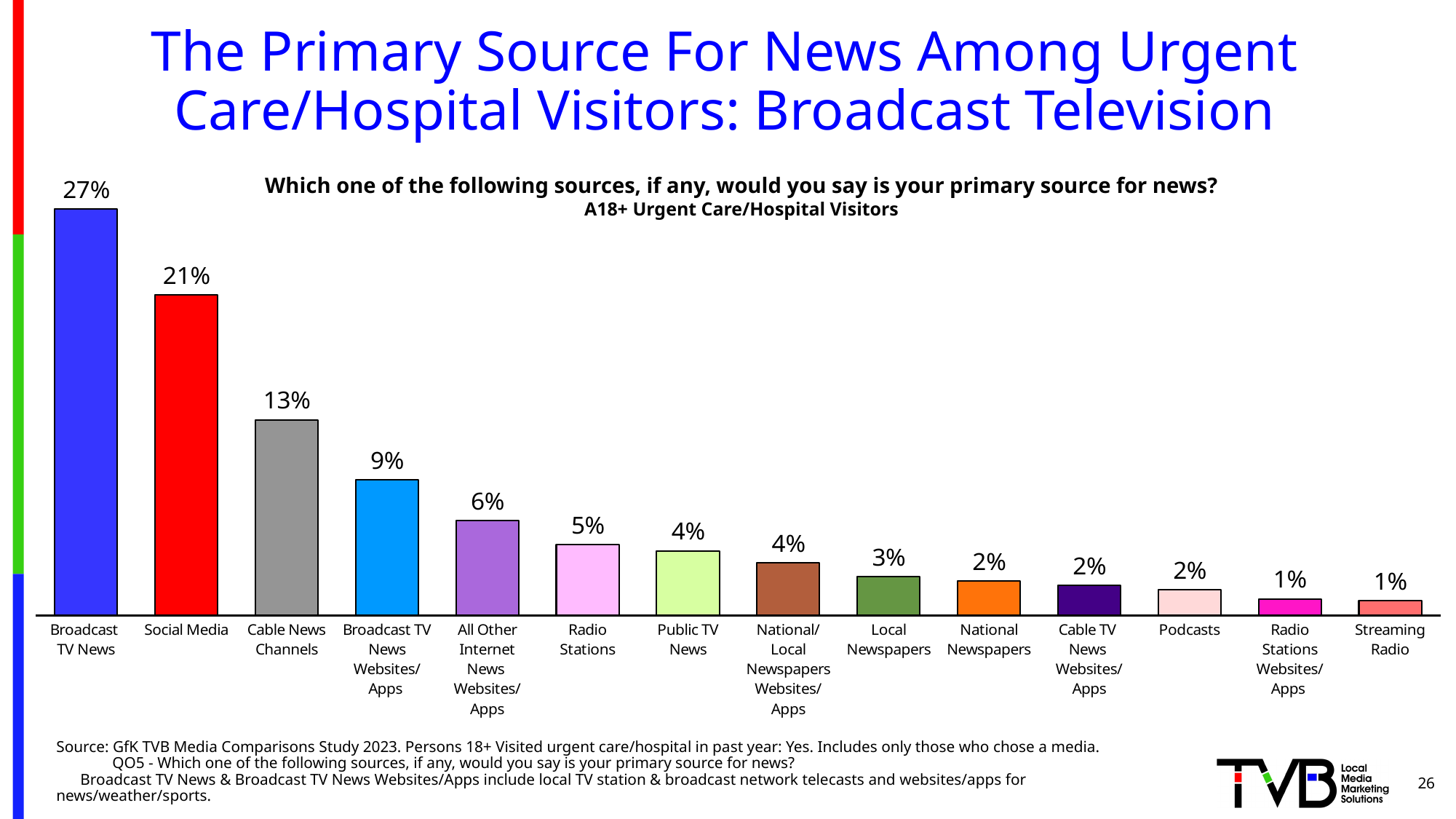
What is the value shown for Cable News Channels? 13% How many sources (categories) are shown in the chart? 14 What percentage of urgent care/hospital visitors say Broadcast TV News is their primary source for news? 27% What audience is described in the chart's subtitle? A18+ Urgent Care/Hospital Visitors What is the value shown for Public TV News? 4% What is the difference between the values for Broadcast TV News and Social Media? 6% Do the values rise or fall moving from left to right across the chart? Fall What is the value shown for Social Media? 21% What is the difference between the values for Cable News Channels and Broadcast TV News Websites/Apps? 4% Which source has the highest value in the chart? Broadcast TV News Which is larger, the value for Radio Stations or the value for Local Newspapers? Radio Stations What kind of chart is shown on the slide? Bar chart